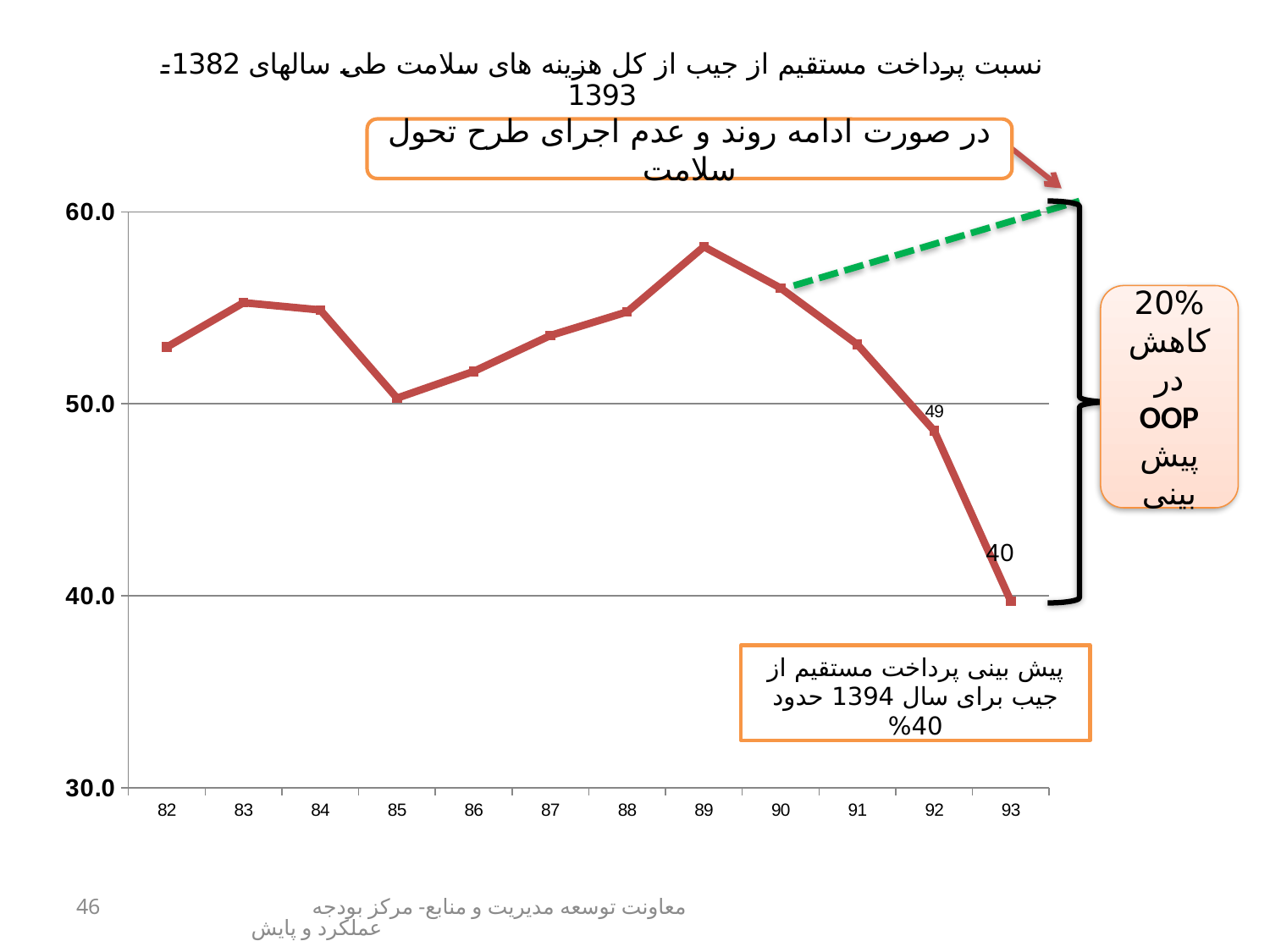
What is the value shown for year 92? 49 Which year has the lowest value on the line? 93 What colour is the dashed projection line extending from year 90? green Is the value for year 89 greater or less than 50.0? greater Which year has the highest value on the line? 89 Is the value for year 93 greater or less than 50.0? less Which year has the larger value, 89 or 90? 89 How many years are plotted along the x axis of the chart? 12 What is the value shown for year 93? 40 What kind of chart is shown on the slide? line chart What is the difference between the values for year 92 and year 93? 9 Do the values rise or fall from year 89 to year 93? fall